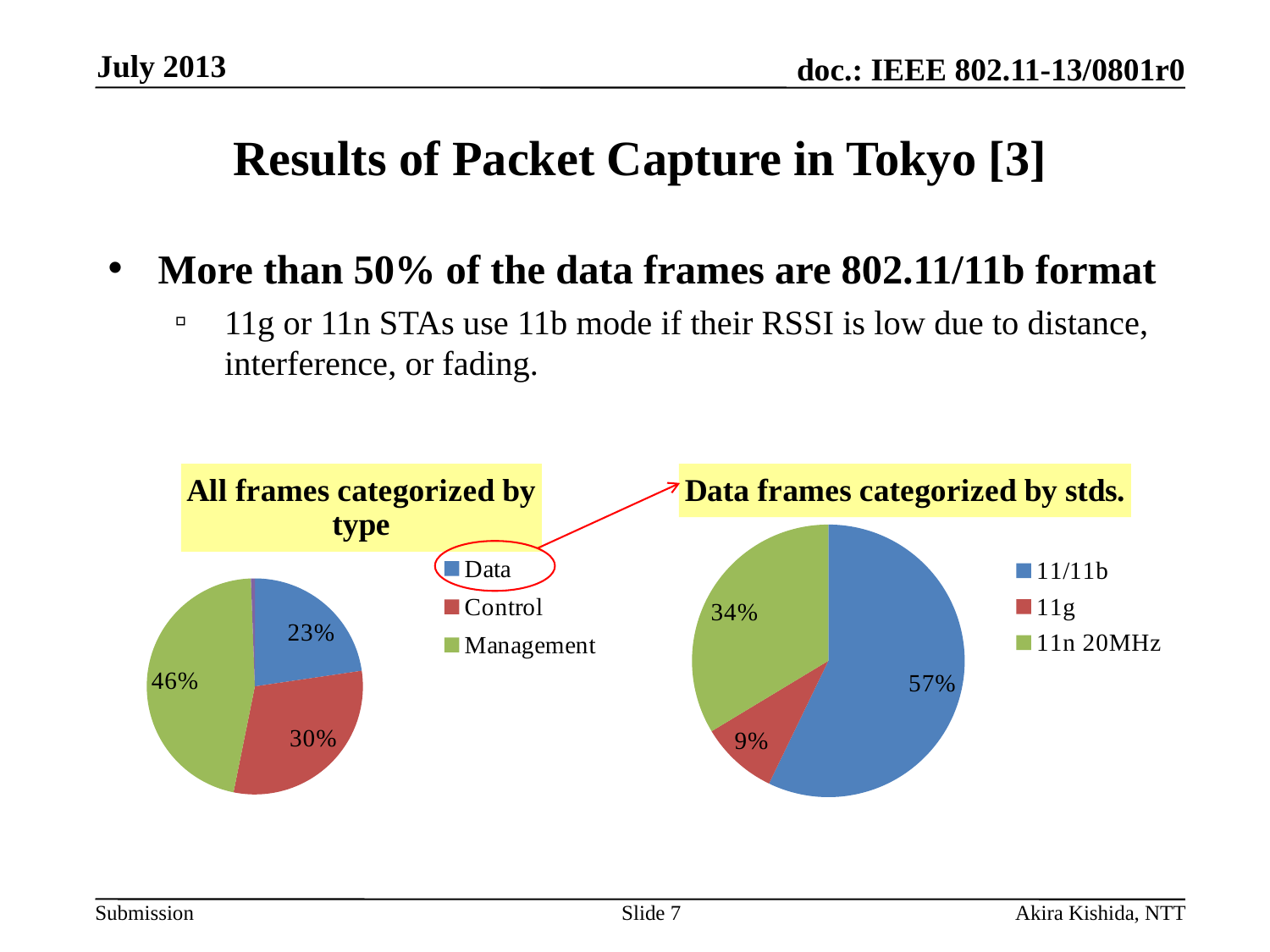
In the 'All frames categorized by type' chart, which is larger, Control or Data? Control In the 'Data frames categorized by stds.' chart, which standard has the smallest share? 11g In the 'All frames categorized by type' chart, what is the difference between the Management and Data shares? 23% In the 'Data frames categorized by stds.' chart, what is the difference between the 11/11b and 11n 20MHz shares? 23% In the 'All frames categorized by type' chart, what share of frames is Data? 23% In the 'All frames categorized by type' chart, which labelled category has the largest share? Management In the 'All frames categorized by type' chart, what share of frames is Management? 46% How many entries does the legend of the 'Data frames categorized by stds.' chart list? 3 In the 'All frames categorized by type' chart, what share of frames is Control? 30% In the 'Data frames categorized by stds.' chart, what share is 11/11b? 57% In the 'Data frames categorized by stds.' chart, what share is 11g? 9% What type of chart is used for 'Data frames categorized by stds.'? Pie chart